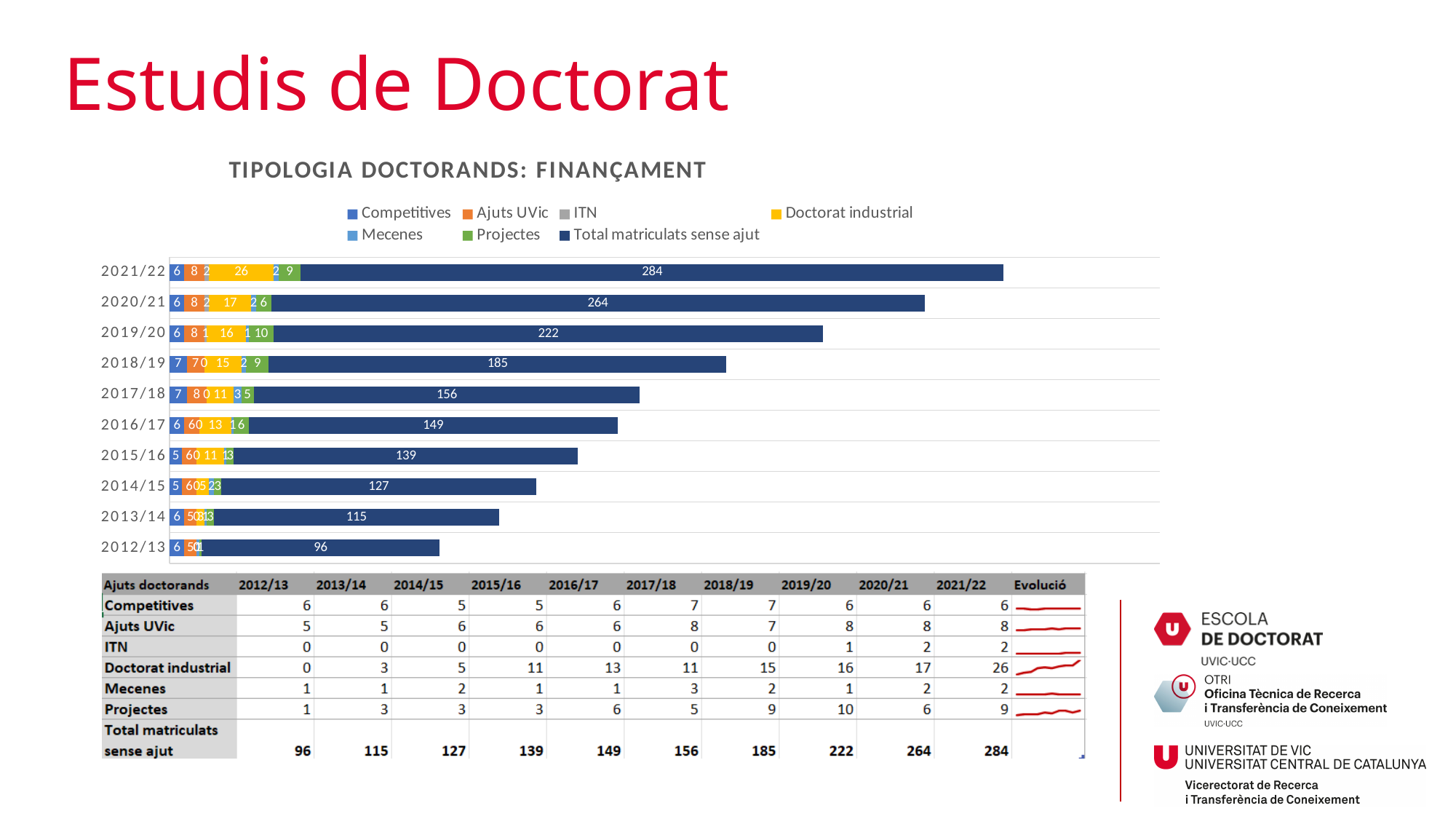
How many series does the legend list? 7 Which academic year has the highest value for Total matriculats sense ajut? 2021/22 What is the value of Projectes for 2019/20? 10 Which academic year has the lowest value for Total matriculats sense ajut? 2012/13 What is the difference between Total matriculats sense ajut in 2021/22 and 2020/21? 20 What kind of chart is shown on the slide? Stacked bar chart What is the value of Total matriculats sense ajut for 2021/22? 284 What is the title of the chart? TIPOLOGIA DOCTORANDS: FINANÇAMENT How many academic years are shown in the chart? 10 What is the value of Doctorat industrial for 2021/22? 26 Does Total matriculats sense ajut rise or fall from 2012/13 to 2021/22? Rise Which is larger, Doctorat industrial in 2021/22 or Doctorat industrial in 2020/21? 2021/22